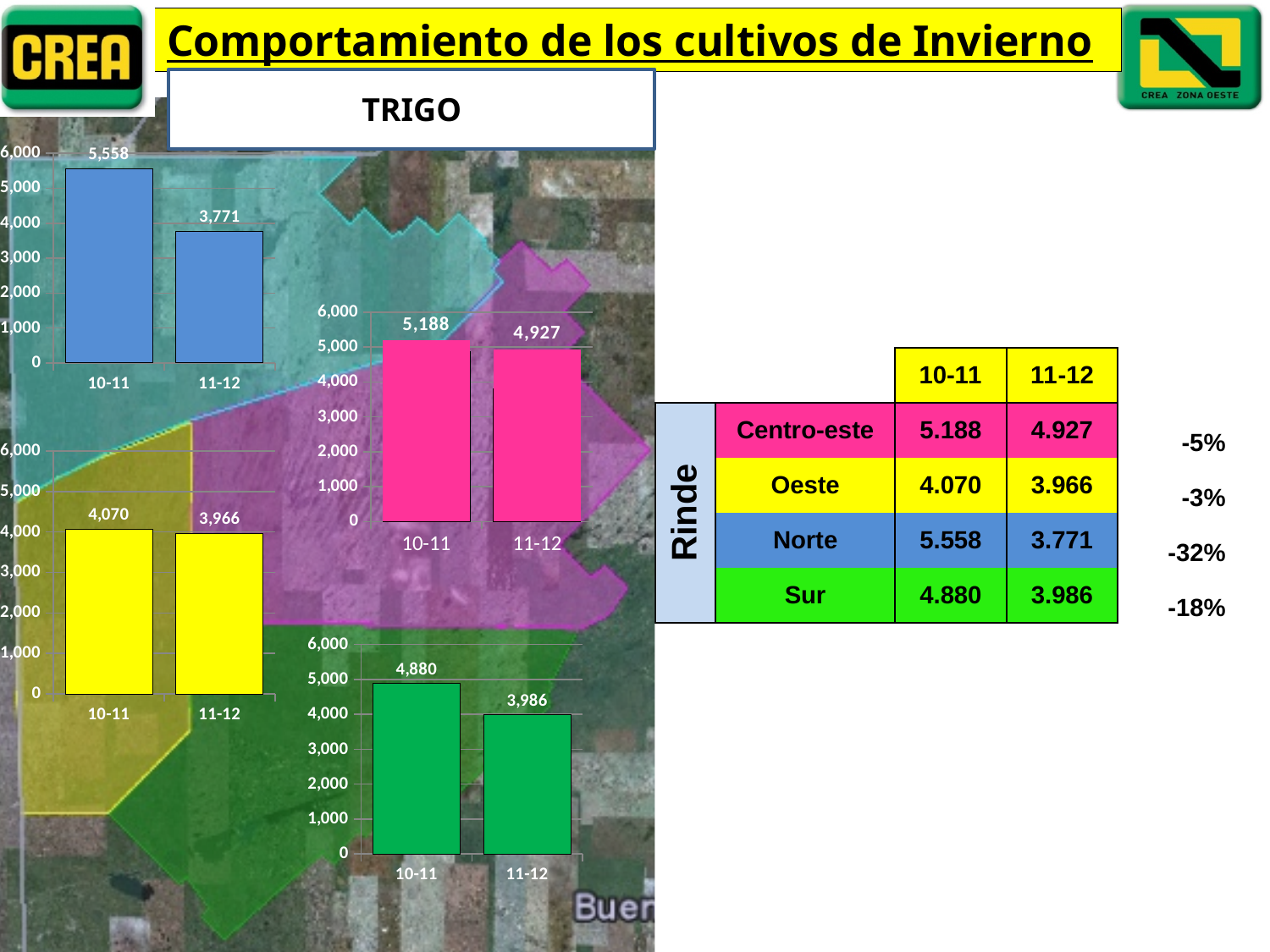
In the yellow bar chart at the bottom left of the slide, what is the value for 10-11? 4,070 In the blue bar chart at the top left of the slide, what is the value for 10-11? 5,558 In the green bar chart at the bottom centre of the slide, which period has the higher value, 10-11 or 11-12? 10-11 What type of chart is the green chart at the bottom centre of the slide? bar chart In the pink bar chart in the centre of the slide, what is the difference between the 10-11 and 11-12 values? 261 In the yellow bar chart at the bottom left of the slide, do the values rise or fall from 10-11 to 11-12? fall In the pink bar chart in the centre of the slide, what is the value for 11-12? 4,927 In the green bar chart at the bottom centre of the slide, what is the value for 11-12? 3,986 How many bars does the pink bar chart in the centre of the slide have? 2 In the blue bar chart at the top left of the slide, what is the value for 11-12? 3,771 In the blue bar chart at the top left of the slide, what is the difference between the 10-11 and 11-12 values? 1,787 What is the maximum value shown on the vertical axis of the blue bar chart at the top left of the slide? 6,000